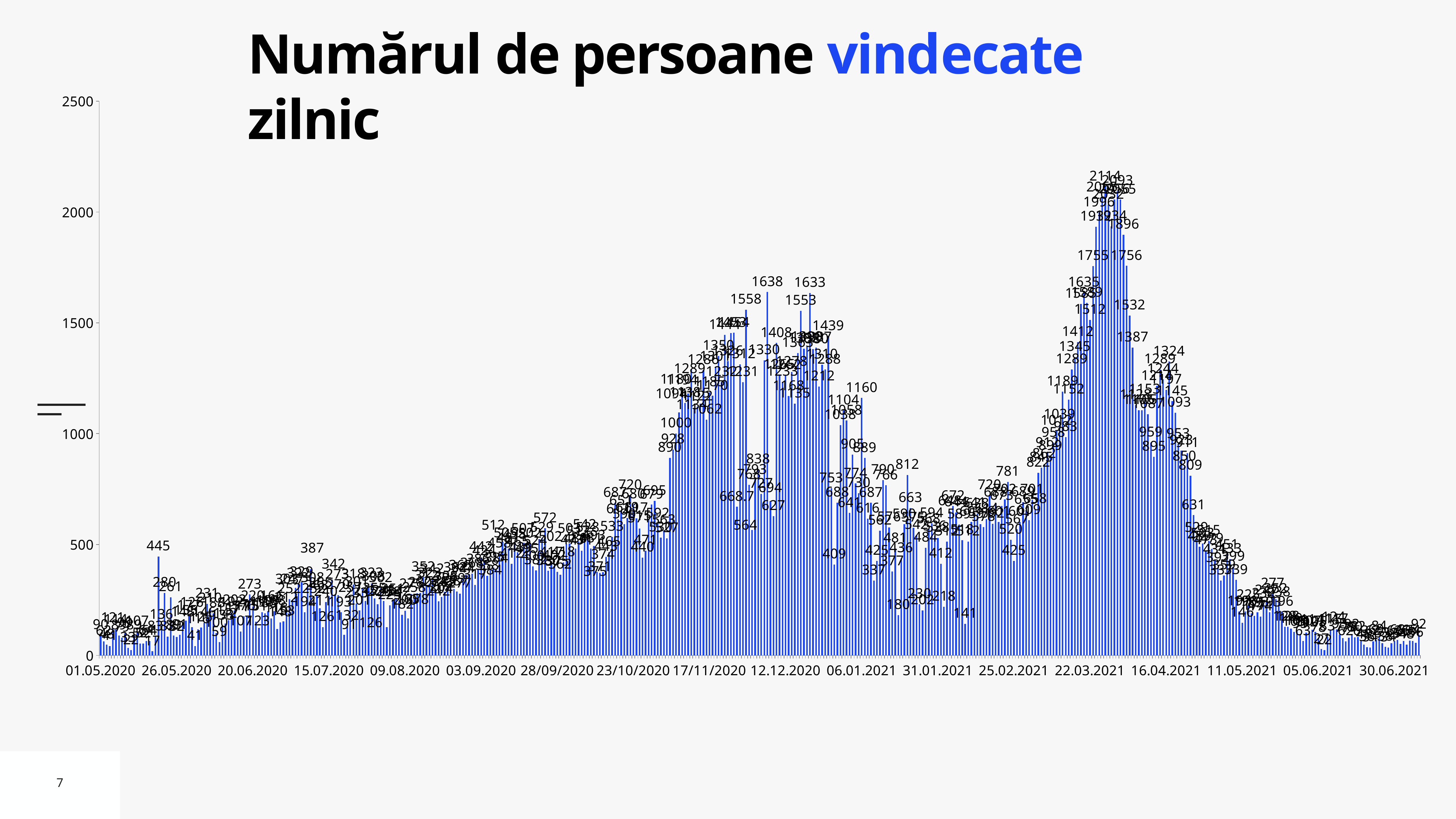
What kind of chart is shown on the slide? bar chart What is the first date shown on the horizontal axis? 01.05.2020 Which is larger, the bar labelled 1638 or the bar labelled 1558? 1638 What is the title of the chart? Numărul de persoane vindecate zilnic Is the value of the bar labelled 445, near 26.05.2020, greater or less than 500? less Do the values generally rise or fall between the peak near 22.03.2021 and 30.06.2021? fall What is the value labelled on the last bar at the right end of the chart? 92 What is the highest tick value shown on the vertical axis? 2500 What is the difference between the bars labelled 1638 and 1558? 80 Is the value of the tallest bar, near 22.03.2021, greater or less than 2000? greater What is the last date shown on the horizontal axis? 30.06.2021 What is the highest value labelled on the chart? 2114